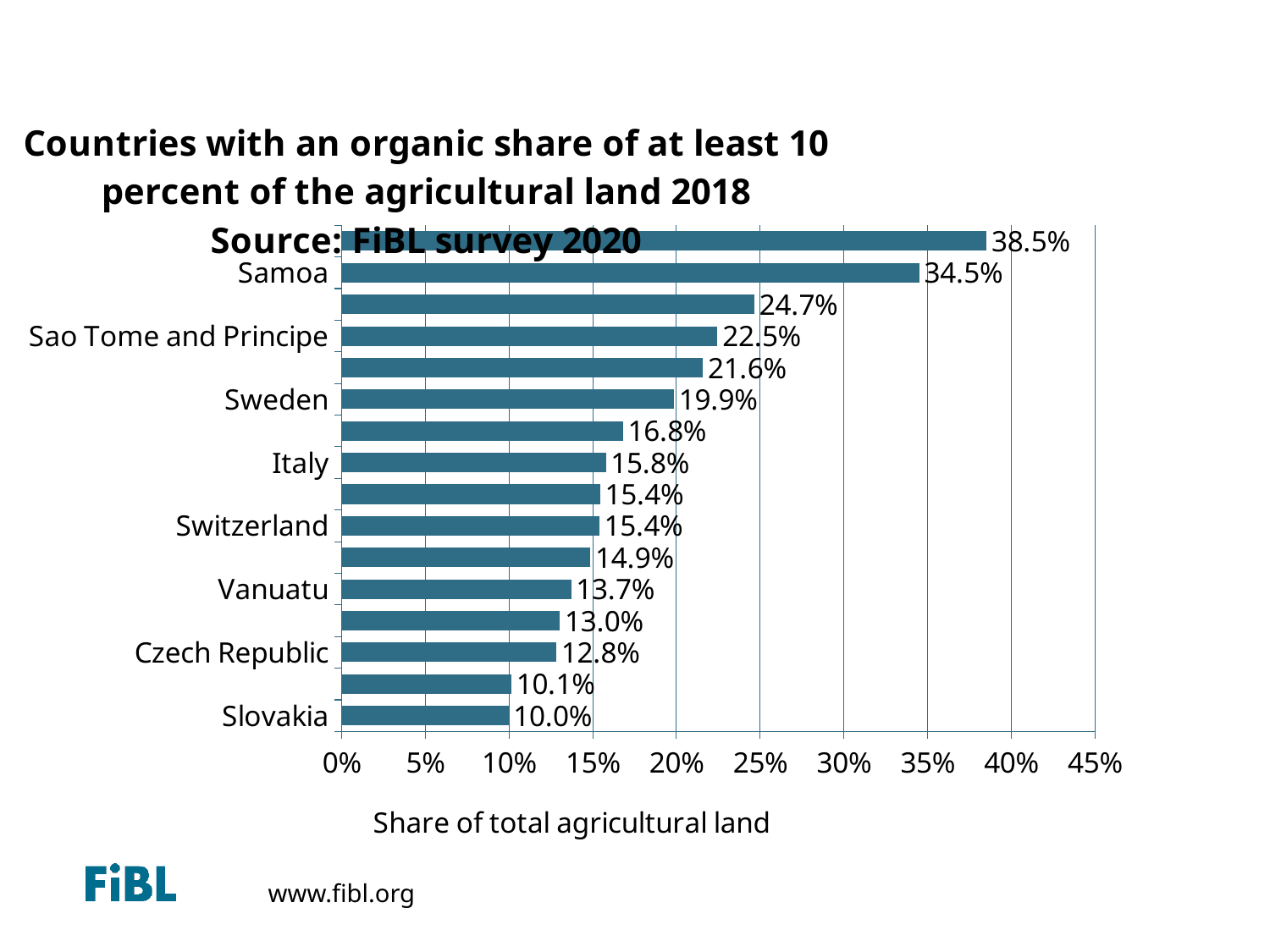
What is the value shown for Sao Tome and Principe? 22.5% What is the title of the horizontal axis? Share of total agricultural land How many bars are plotted on the chart? 16 What value is shown for the Czech Republic? 12.8% What is the organic share of agricultural land for Sweden? 19.9% What kind of chart is shown on the slide? Bar chart What is the highest value shown on the chart? 38.5% Is the value for Vanuatu greater or less than 15%? less Which has a higher organic share, Italy or Switzerland? Italy What is the difference between the values for Samoa and Sweden? 14.6% What is the organic share of agricultural land for Samoa? 34.5% Which labelled country has the lowest organic share of agricultural land? Slovakia